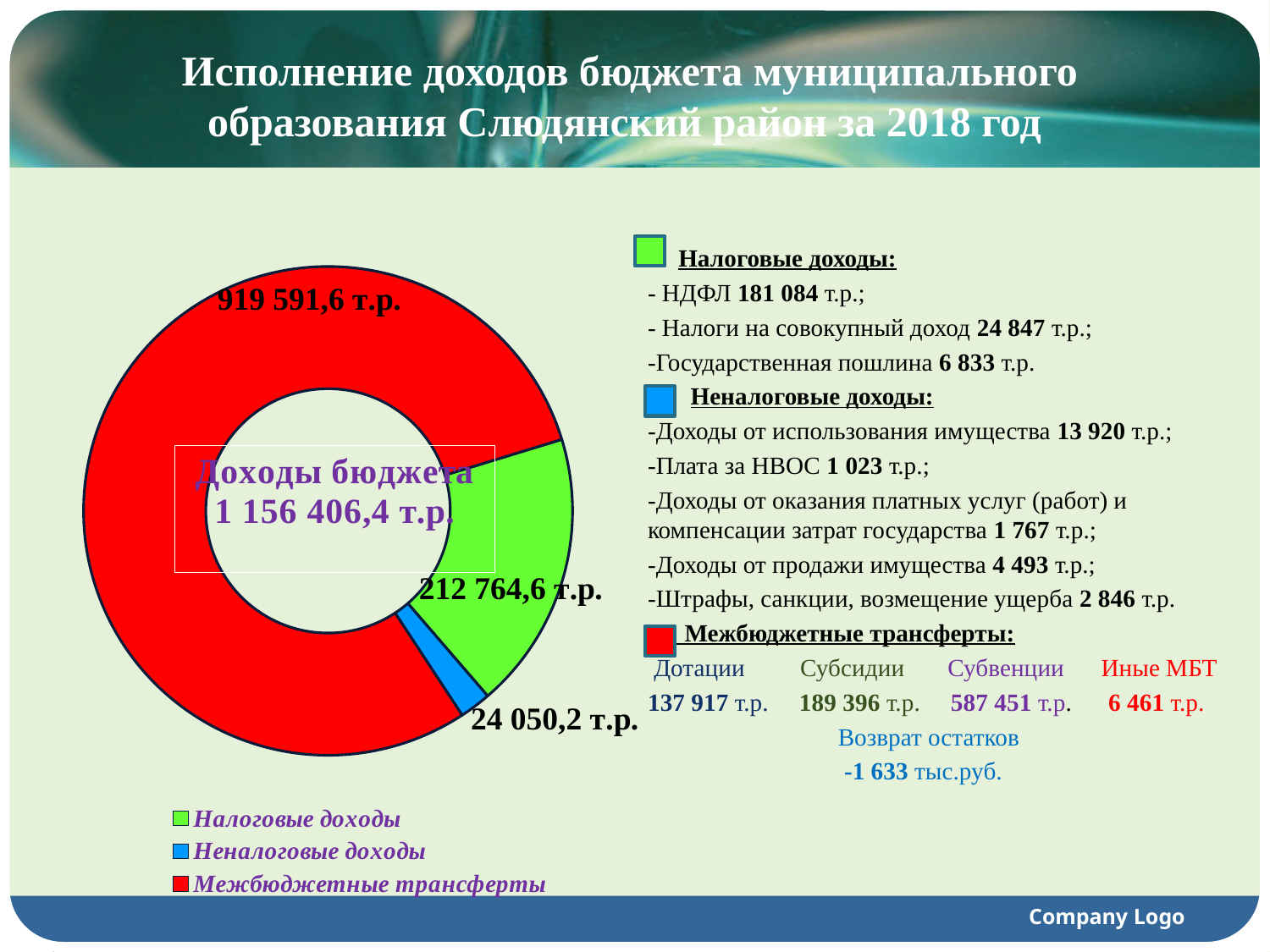
Which is larger, Налоговые доходы or Неналоговые доходы? Налоговые доходы How many categories does the chart show? 3 What type of chart is shown on the slide? Doughnut chart What is the difference between Налоговые доходы and Неналоговые доходы? 188 714,4 т.р. Which category has the smallest share of the chart? Неналоговые доходы What colour represents Неналоговые доходы in the chart? Blue What is the value for Неналоговые доходы in the chart? 24 050,2 т.р. What is the difference between Межбюджетные трансферты and Налоговые доходы? 706 827,0 т.р. What is the value for Межбюджетные трансферты in the chart? 919 591,6 т.р. Which category has the largest share of the chart? Межбюджетные трансферты What total value is shown in the centre of the chart (Доходы бюджета)? 1 156 406,4 т.р. What is the value for Налоговые доходы in the chart? 212 764,6 т.р.